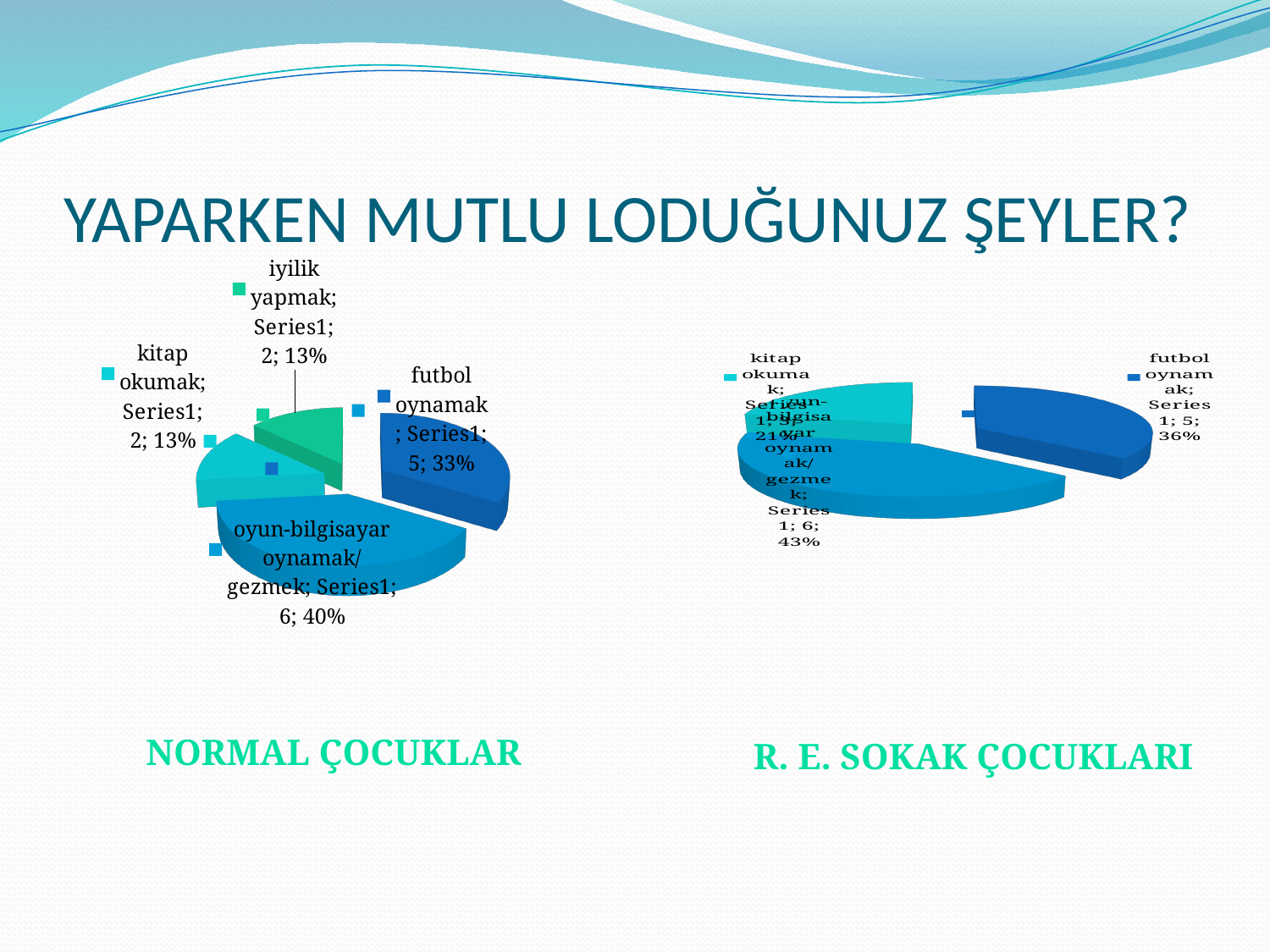
In the NORMAL ÇOCUKLAR pie chart, what percentage share does 'kitap okumak' have? 13% In the R. E. SOKAK ÇOCUKLARI pie chart, which category has the largest share? oyun-bilgisayar oynamak/gezmek What type of chart is used for the NORMAL ÇOCUKLAR data? pie chart In the R. E. SOKAK ÇOCUKLARI pie chart, what percentage share does 'futbol oynamak' have? 36% In the NORMAL ÇOCUKLAR pie chart, what percentage share does 'futbol oynamak' have? 33% In the NORMAL ÇOCUKLAR pie chart, what is the difference in value between 'oyun-bilgisayar oynamak/gezmek' and 'iyilik yapmak'? 4 In the NORMAL ÇOCUKLAR pie chart, what is the value for 'oyun-bilgisayar oynamak/gezmek'? 6 What is the title of the slide containing the two pie charts? YAPARKEN MUTLU LODUĞUNUZ ŞEYLER? How many slices does the NORMAL ÇOCUKLAR pie chart have? 4 In the NORMAL ÇOCUKLAR pie chart, which category has the largest share? oyun-bilgisayar oynamak/gezmek In the R. E. SOKAK ÇOCUKLARI pie chart, which is larger: 'futbol oynamak' or 'kitap okumak'? futbol oynamak